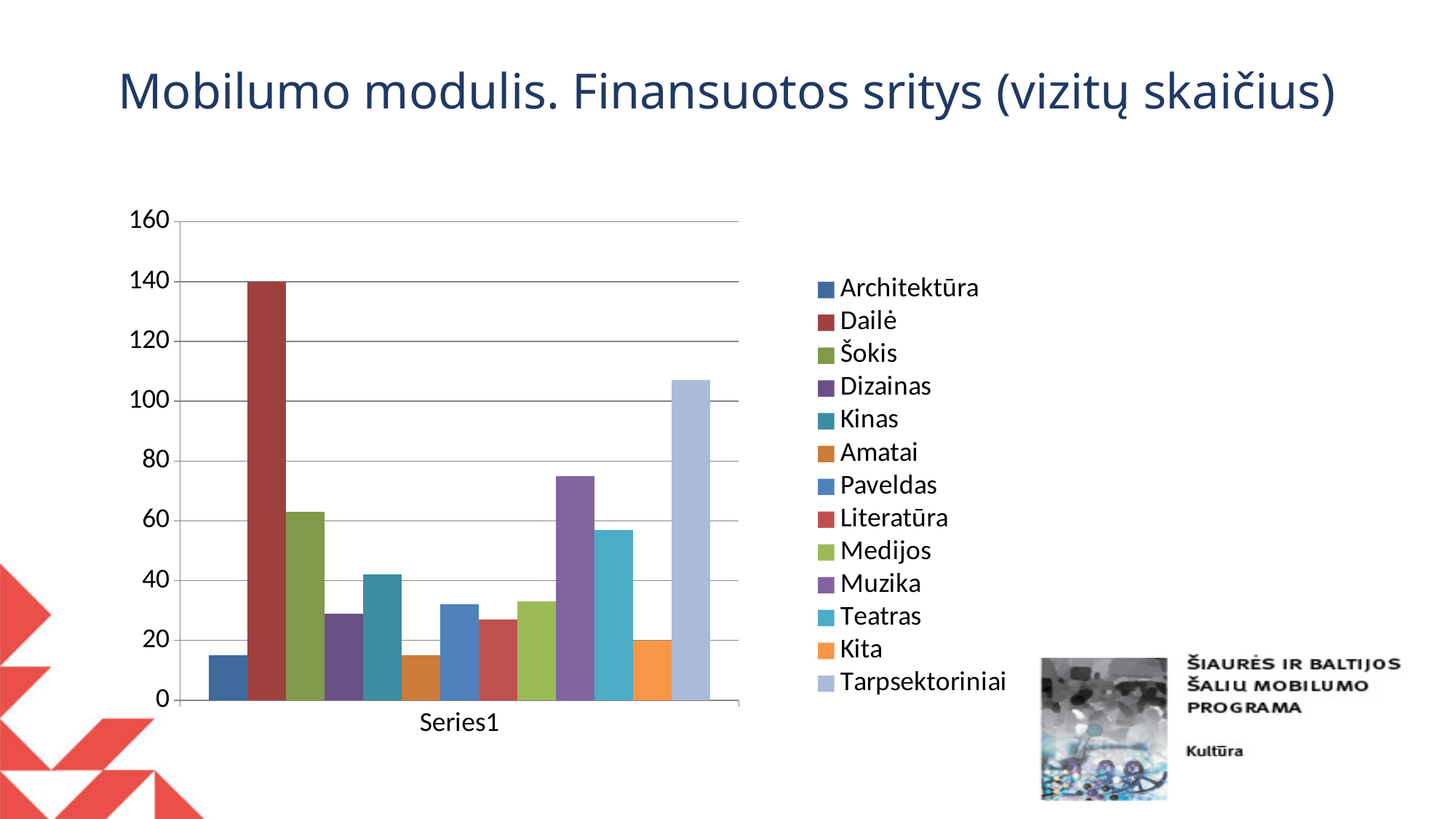
Which is larger, the value for Muzika or the value for Šokis? Muzika Is the value for Teatras greater or less than 60? less What kind of chart is shown on the slide? bar chart What label is shown on the x axis of the chart? Series1 Is the value for Šokis greater or less than 60? greater Which is larger, the value for Kinas or the value for Dizainas? Kinas Is the value for Architektūra greater or less than 20? less What is the title of the slide containing the chart? Mobilumo modulis. Finansuotos sritys (vizitų skaičius) Which category has the highest bar in the chart? Dailė How many entries does the chart's legend list? 13